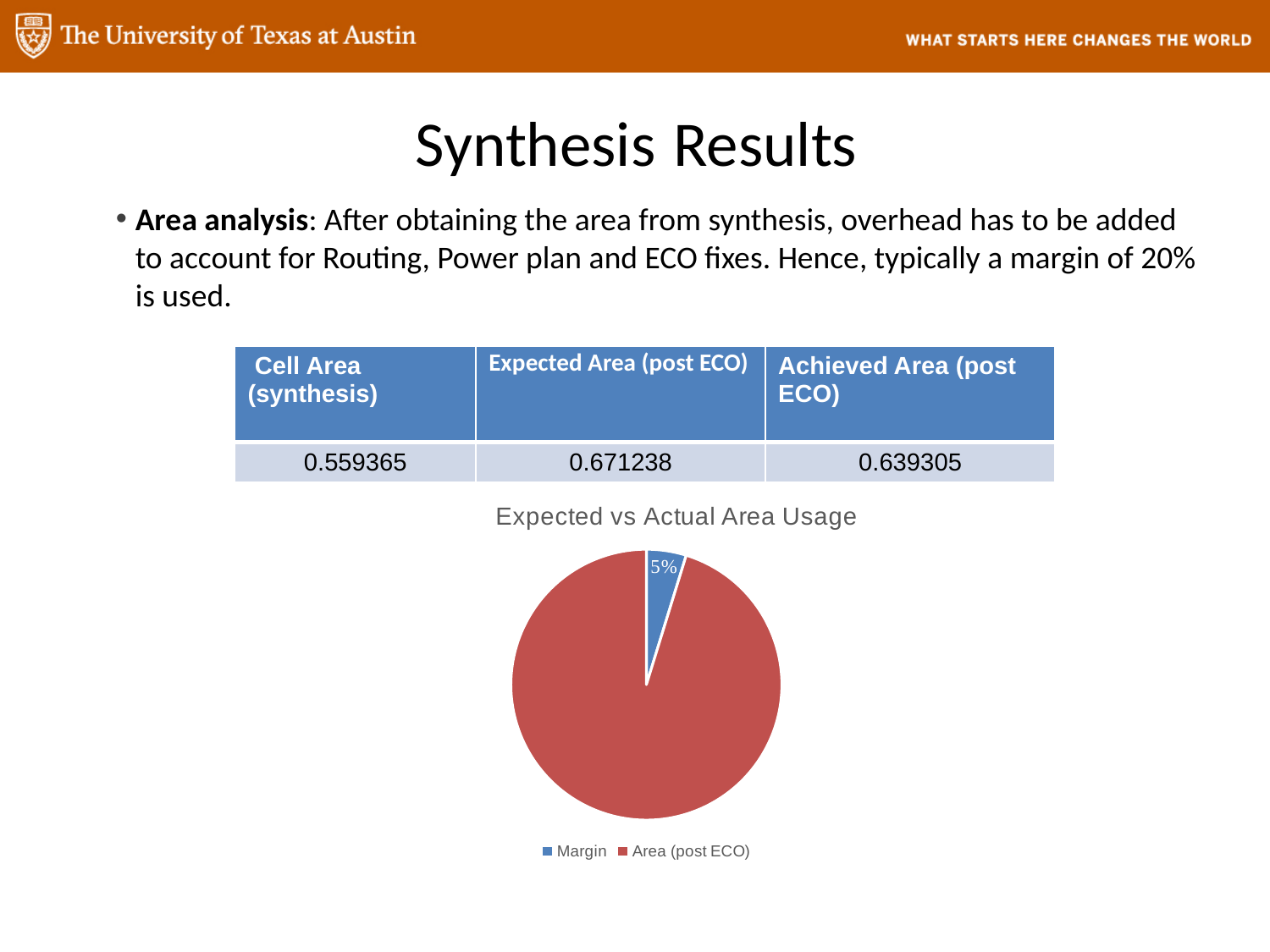
Is the share for Area (post ECO) greater or less than 50%? greater How many slices does the pie chart have? 2 Which slice of the pie chart is the smallest? Margin Which slice of the pie chart is the largest? Area (post ECO) What colour is the Margin slice in the pie chart? blue What kind of chart is shown on the slide? pie chart What is the title of the chart on the slide? Expected vs Actual Area Usage How many entries does the chart's legend list? 2 Which is larger in the pie chart, Margin or Area (post ECO)? Area (post ECO) What share of the pie does the Margin slice represent? 5%